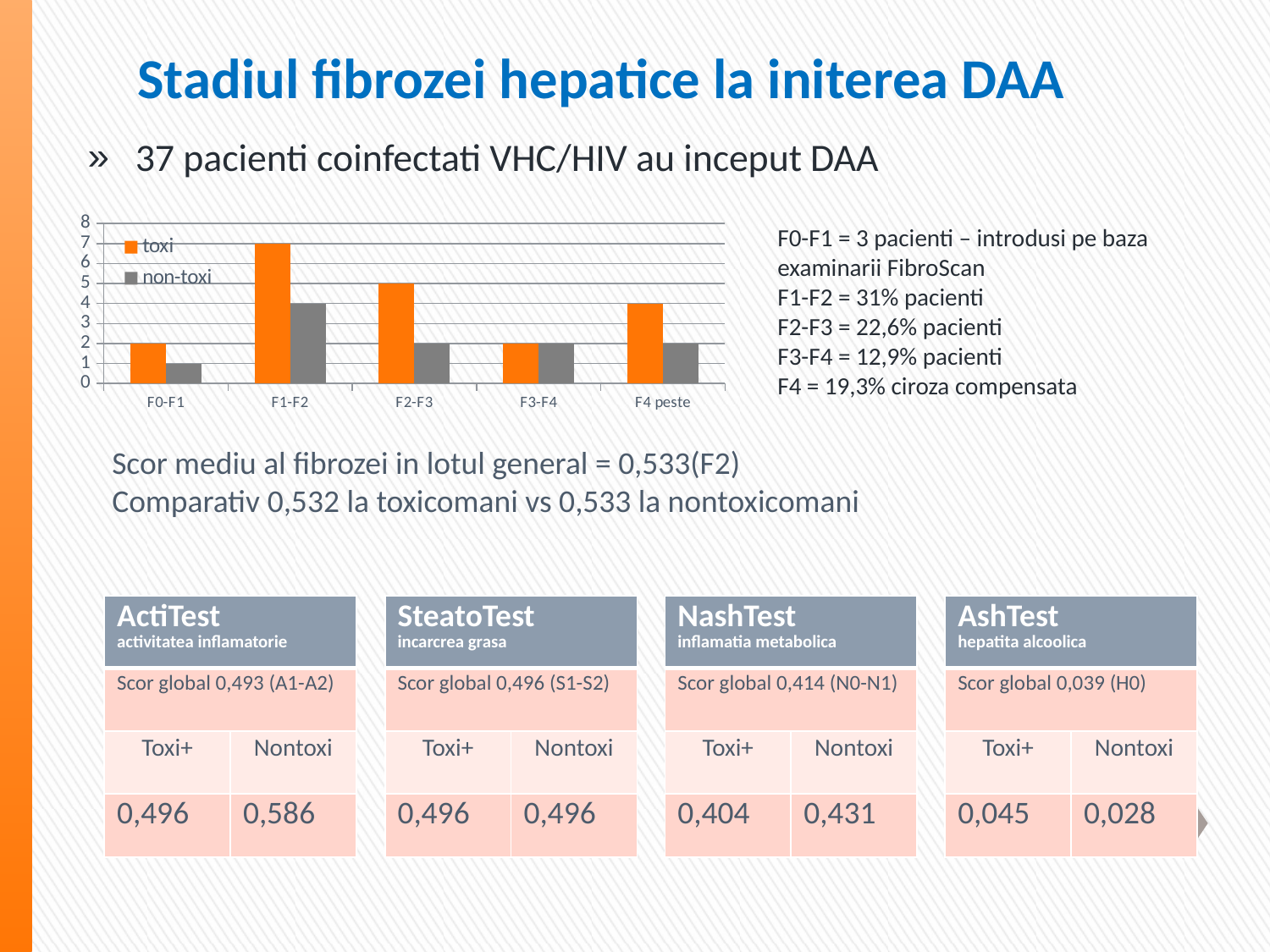
Which colour represents the non-toxi series in the chart? gray What is the value of the toxi series for F2-F3? 5 What is the value of the non-toxi series for F0-F1? 1 For F4 peste, which series has the larger value, toxi or non-toxi? toxi What kind of chart is shown on the slide? bar chart Is the value of the toxi series for F1-F2 greater or less than 6? greater What is the difference between the toxi and non-toxi values for F1-F2? 3 How many categories are shown on the x axis of the chart? 5 What is the value of the toxi series for F1-F2? 7 How many series does the chart legend list? 2 Which category has the highest value for the toxi series? F1-F2 Which category has the lowest value for the non-toxi series? F0-F1